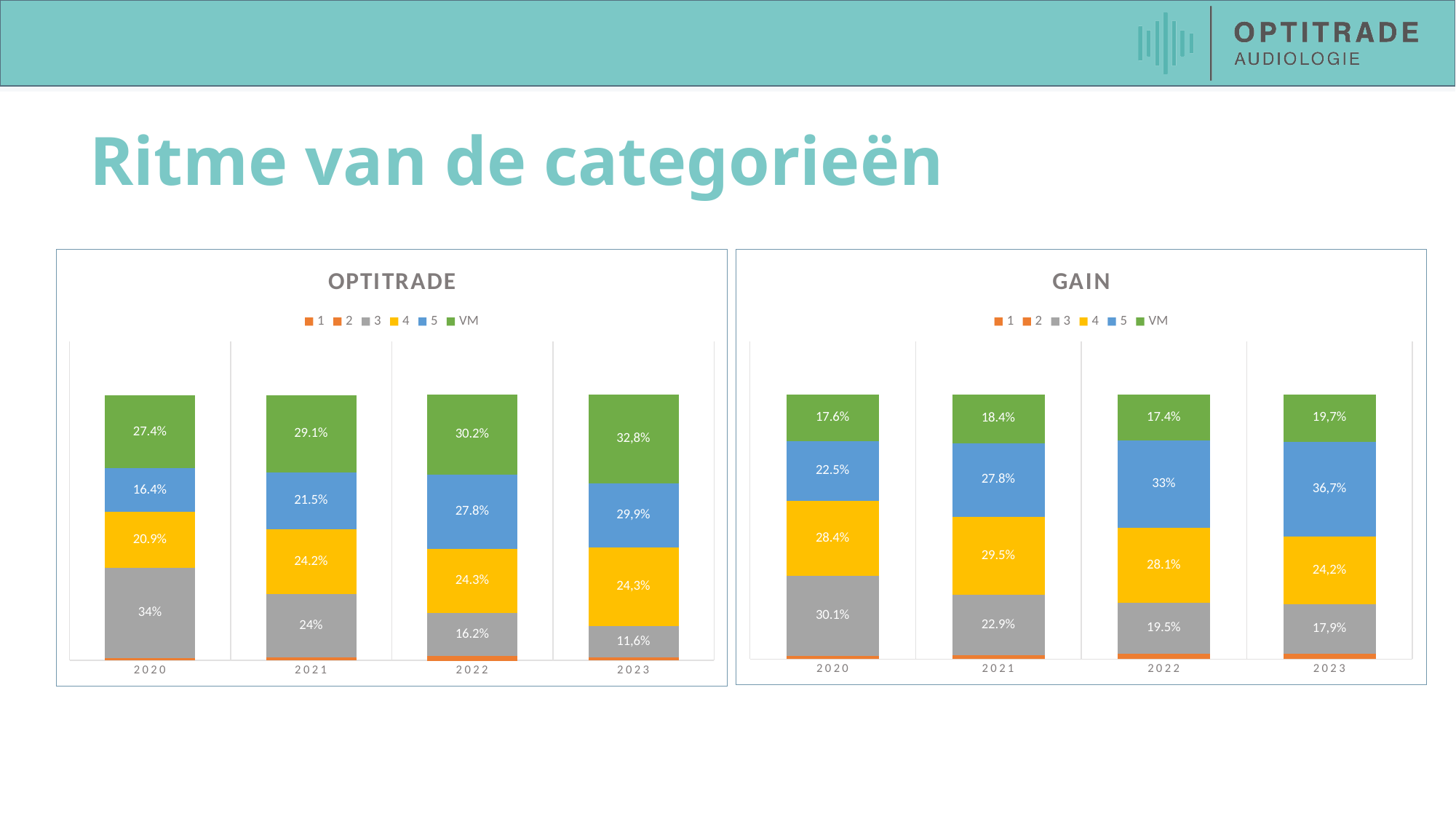
In the OPTITRADE chart, in which year is the value of series 3 lowest? 2023 What kind of chart is the OPTITRADE chart? stacked bar chart In the OPTITRADE chart, what is the difference between the VM value for 2023 and the VM value for 2020? 5.4% In the GAIN chart, which is larger: series 3 in 2020 or series 3 in 2023? series 3 in 2020 In the OPTITRADE chart, does the value of series 5 rise or fall from 2020 to 2023? rise How many series does the legend of the GAIN chart list? 6 In the OPTITRADE chart, what is the value of series 3 for 2020? 34% In the OPTITRADE chart, what is the value of series VM for 2023? 32,8% How many years are shown on the x axis of the OPTITRADE chart? 4 In the GAIN chart, in which year is the value of series 5 highest? 2023 In the GAIN chart, what is the value of series 5 for 2022? 33% In the GAIN chart, what is the value of series 4 for 2021? 29.5%